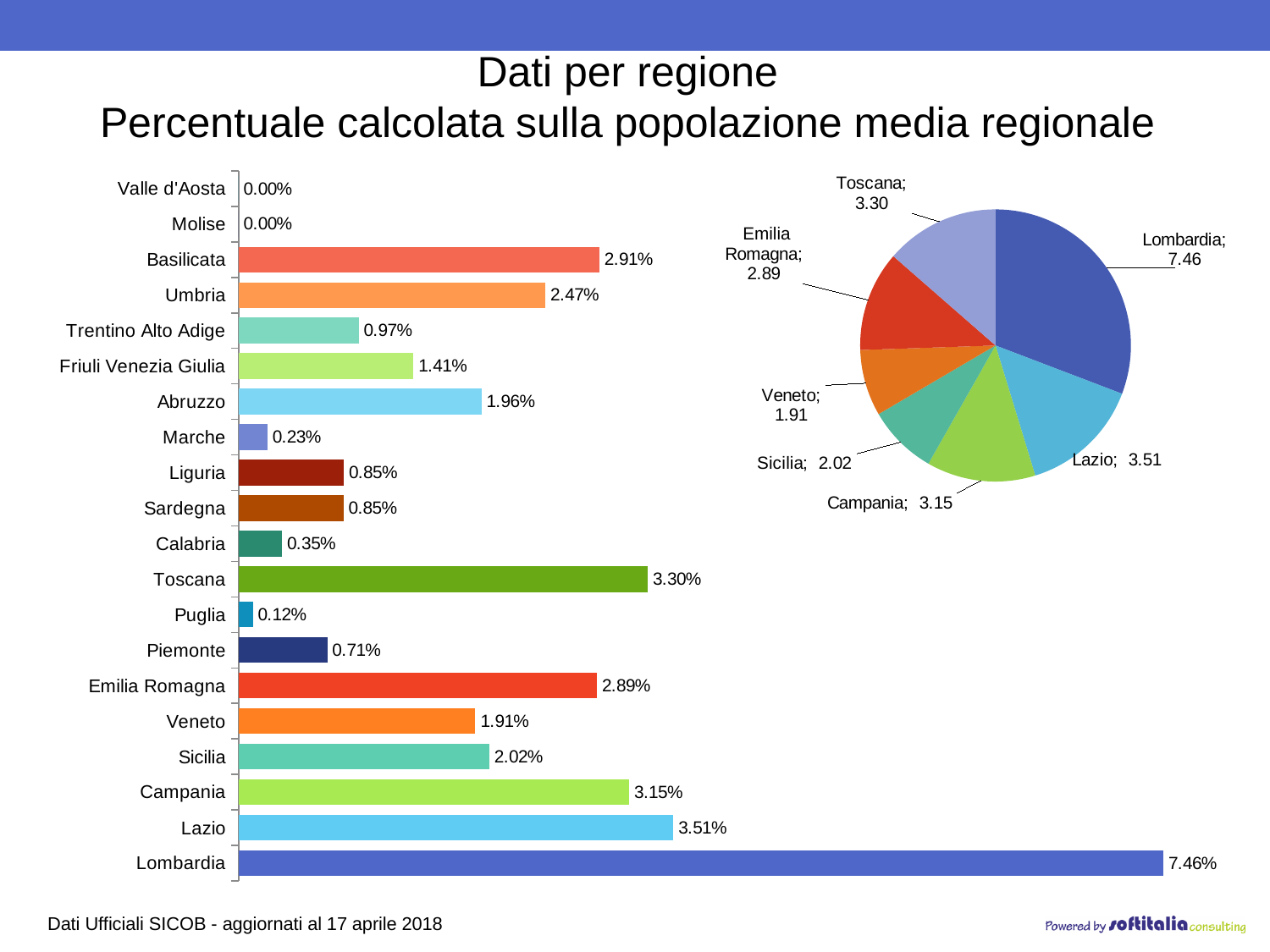
On the bar chart on the left, what is the value for Friuli Venezia Giulia? 1.41% On the bar chart on the left, what is the value for Lombardia? 7.46% On the pie chart on the right, which region has the largest slice? Lombardia How many slices does the pie chart on the right have? 7 On the pie chart on the right, what is the value shown for Campania? 3.15 On the bar chart on the left, which region has the lowest non-zero value? Puglia How many regions are shown on the bar chart on the left? 20 On the bar chart on the left, what is the difference between the values for Lombardia and Lazio? 3.95% On the bar chart on the left, which is larger, the value for Basilicata or the value for Umbria? Basilicata What kind of chart is the chart on the left of the slide? Bar chart On the bar chart on the left, which region has the highest value? Lombardia On the bar chart on the left, which two regions both show a value of 0.00%? Valle d'Aosta and Molise